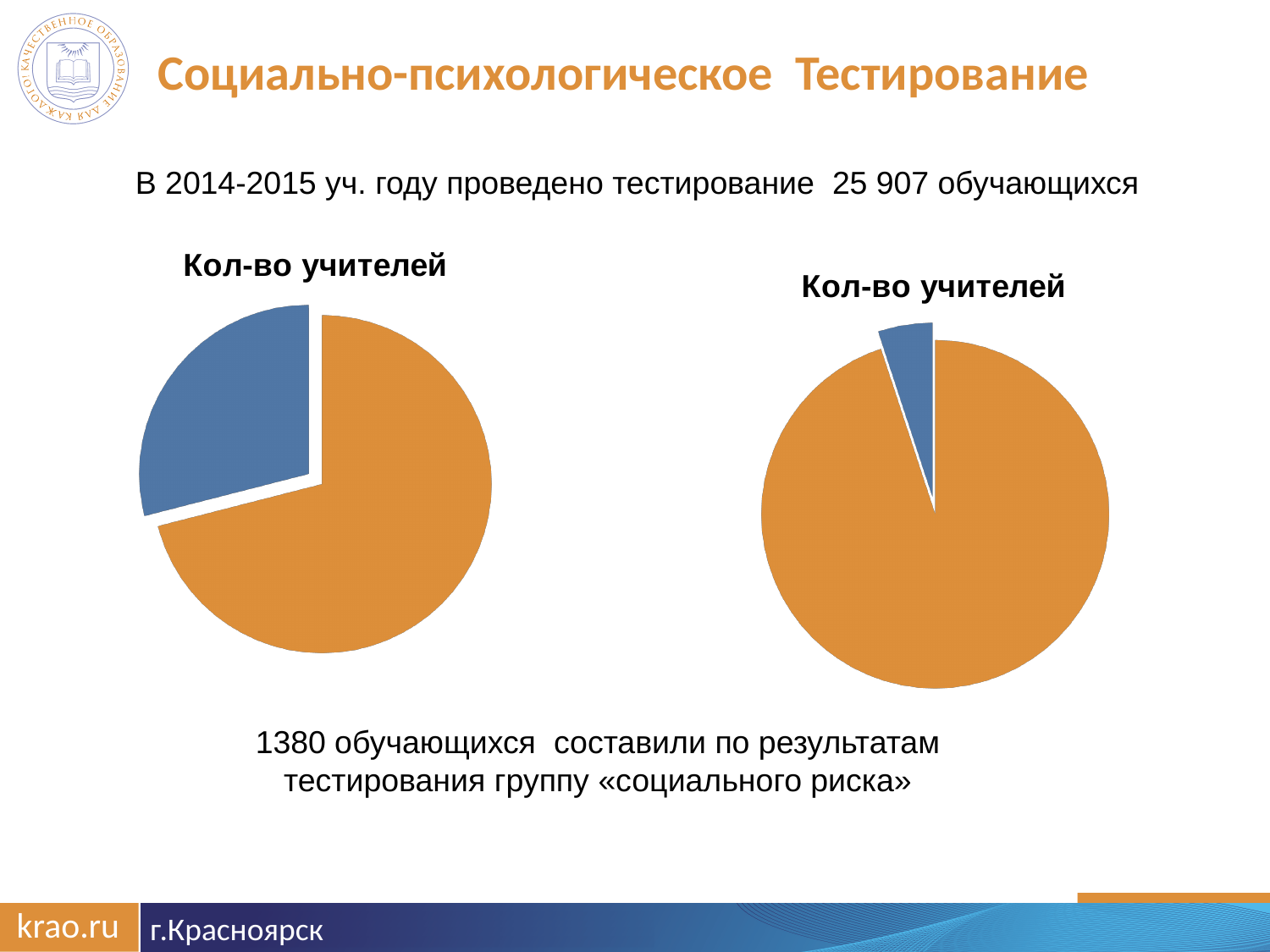
What is the title of the left pie chart? Кол-во учителей Which slice is the smallest in the left pie chart? the blue slice What colour is the largest slice in the right pie chart? orange What kind of chart is the chart on the left side of the slide? pie chart What kind of chart is the chart on the right side of the slide? pie chart Which pie chart has the larger blue slice, the left one or the right one? the left one In the right pie chart, which slice is larger, the orange one or the blue one? the orange one How many slices does the right pie chart have? 2 How many slices does the left pie chart have? 2 In the left pie chart, which slice is larger, the orange one or the blue one? the orange one Which slice is the largest in the right pie chart? the orange slice